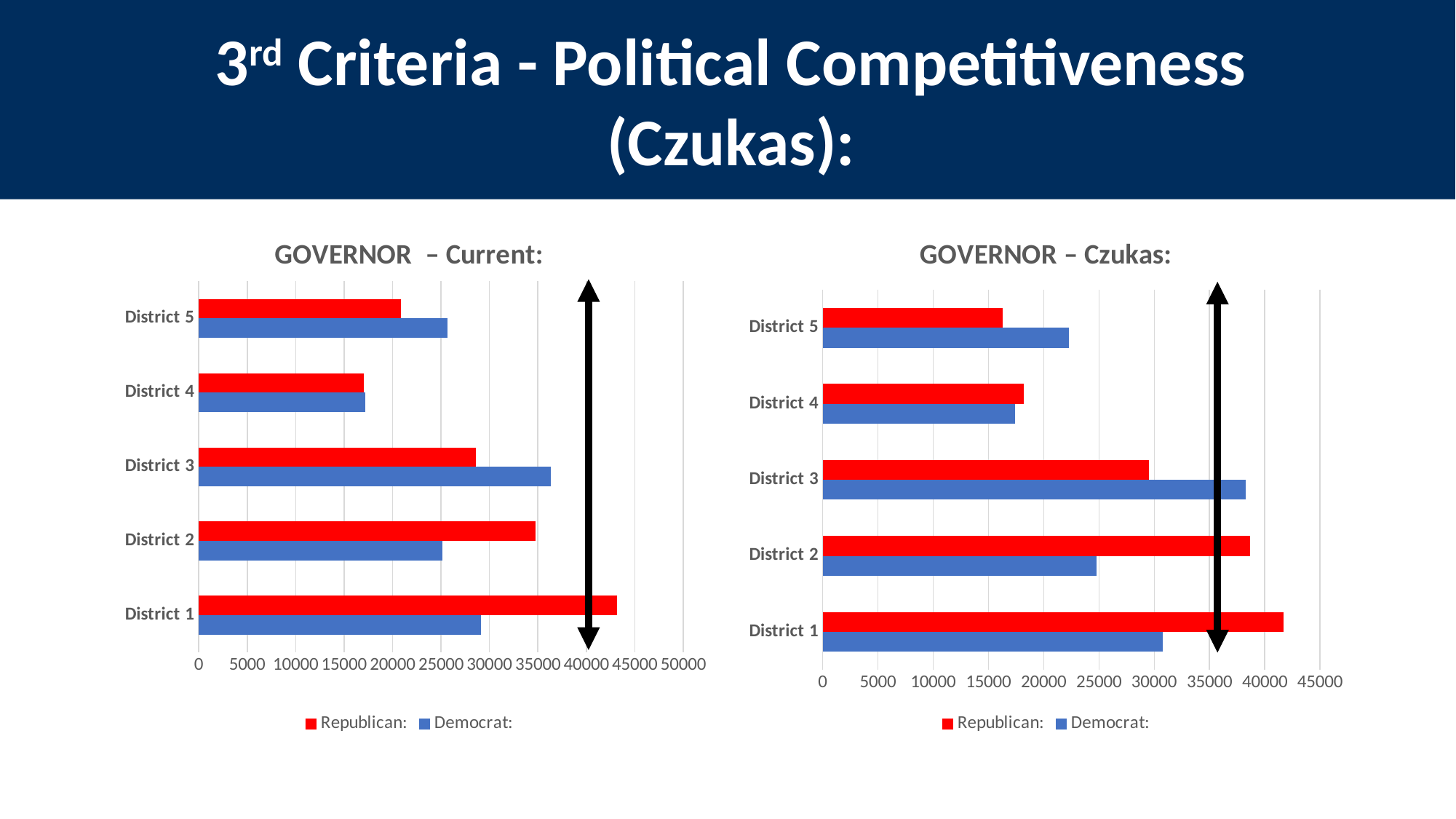
In the GOVERNOR – Czukas chart, which district has the lowest Democrat value? District 4 How many districts are shown in the GOVERNOR – Current chart? 5 In the GOVERNOR – Czukas chart, which is larger for District 2, the Republican value or the Democrat value? Republican How many series does the legend of the GOVERNOR – Current chart list? 2 What are the two legend entries in the GOVERNOR – Czukas chart? Republican and Democrat In the GOVERNOR – Current chart, which district has the lowest Republican value? District 4 In the GOVERNOR – Current chart, which is larger for District 3, the Republican value or the Democrat value? Democrat What kind of chart is the GOVERNOR – Current chart on the left? bar chart In the GOVERNOR – Czukas chart, which district has the highest Democrat value? District 3 In the GOVERNOR – Current chart, is the Republican value for District 1 greater or less than 40000? greater In the GOVERNOR – Current chart, which district has the highest Republican value? District 1 In the GOVERNOR – Czukas chart, is the Republican value for District 5 greater or less than 20000? less